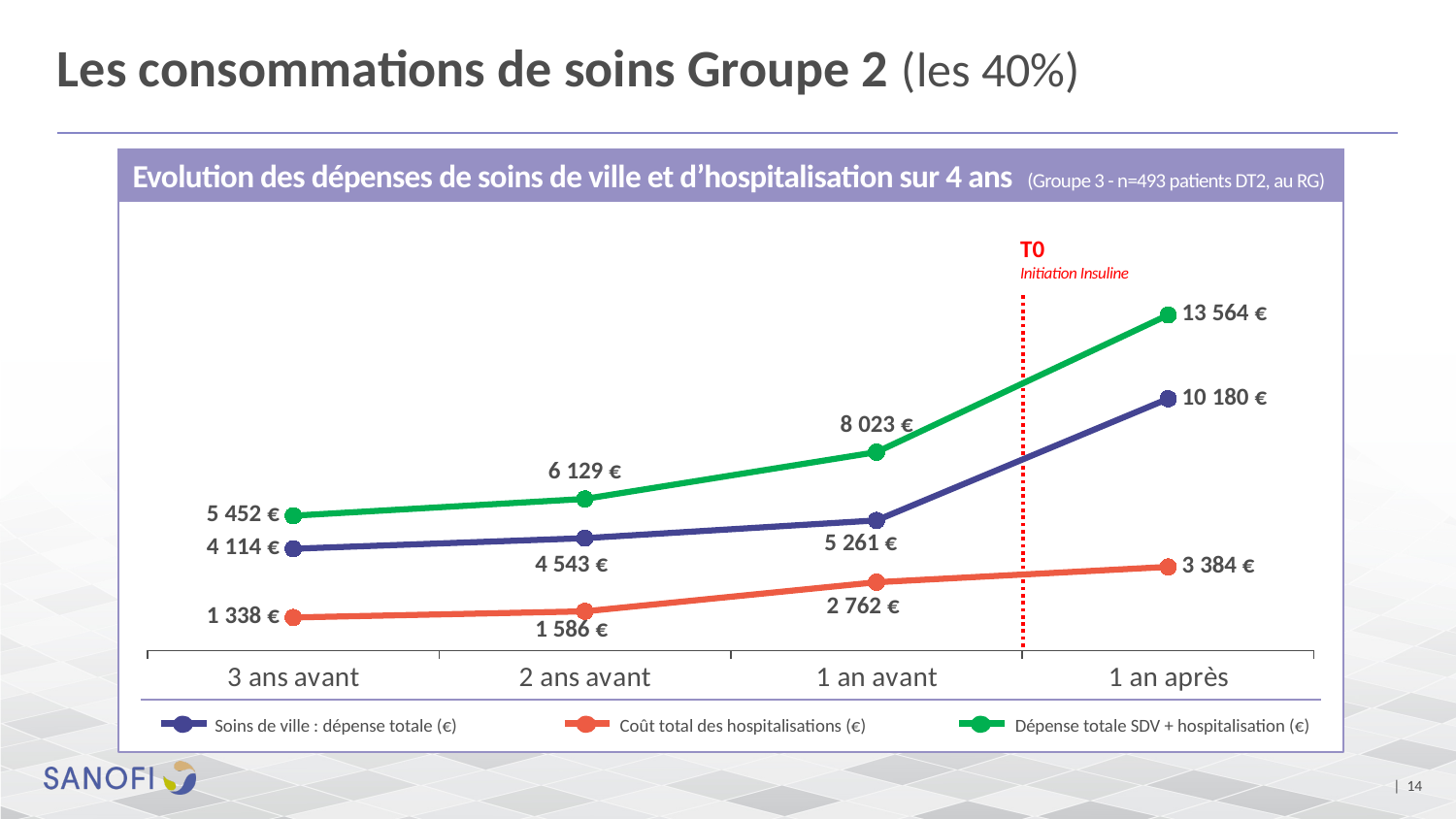
What is the value of 'Coût total des hospitalisations (€)' at '1 an avant'? 2 762 € At which time point is 'Coût total des hospitalisations (€)' lowest? 3 ans avant Do the values of 'Dépense totale SDV + hospitalisation (€)' rise or fall from '3 ans avant' to '1 an après'? Rise Which is larger at '3 ans avant': 'Soins de ville : dépense totale (€)' or 'Coût total des hospitalisations (€)'? Soins de ville : dépense totale (€) How many time points are shown on the x axis? 4 How many series does the legend list? 3 What is the value of 'Dépense totale SDV + hospitalisation (€)' at '1 an après'? 13 564 € What is the value of 'Soins de ville : dépense totale (€)' at '2 ans avant'? 4 543 € At which time point is 'Soins de ville : dépense totale (€)' highest? 1 an après By how much does 'Soins de ville : dépense totale (€)' increase from '1 an avant' to '1 an après'? 4 919 € What type of chart is shown on the slide? Line chart What is the difference between 'Dépense totale SDV + hospitalisation (€)' and 'Soins de ville : dépense totale (€)' at '1 an après'? 3 384 €